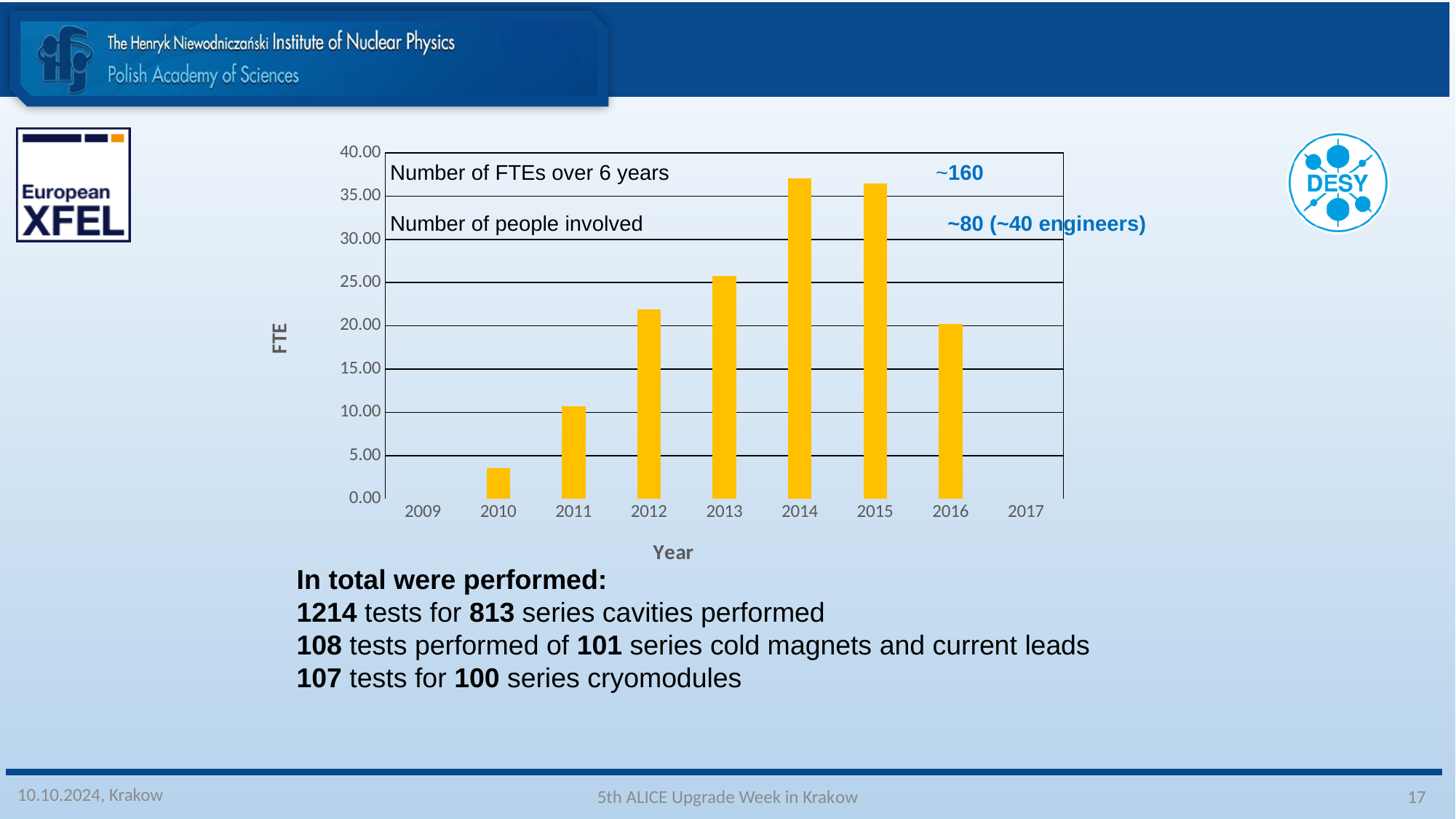
Is the FTE value for 2011 greater or less than 15.00? less Which year has the higher FTE value, 2013 or 2016? 2013 What is the label of the vertical axis of the chart? FTE What kind of chart is shown on the slide? bar chart Do the FTE values rise or fall from 2010 to 2014? rise Which year has the lowest FTE bar in the chart? 2010 What is the label of the horizontal axis of the chart? Year Is the FTE value for 2012 greater or less than 20.00? greater Is the FTE value for 2014 greater or less than 35.00? greater How many years in the chart have a visible FTE bar? 7